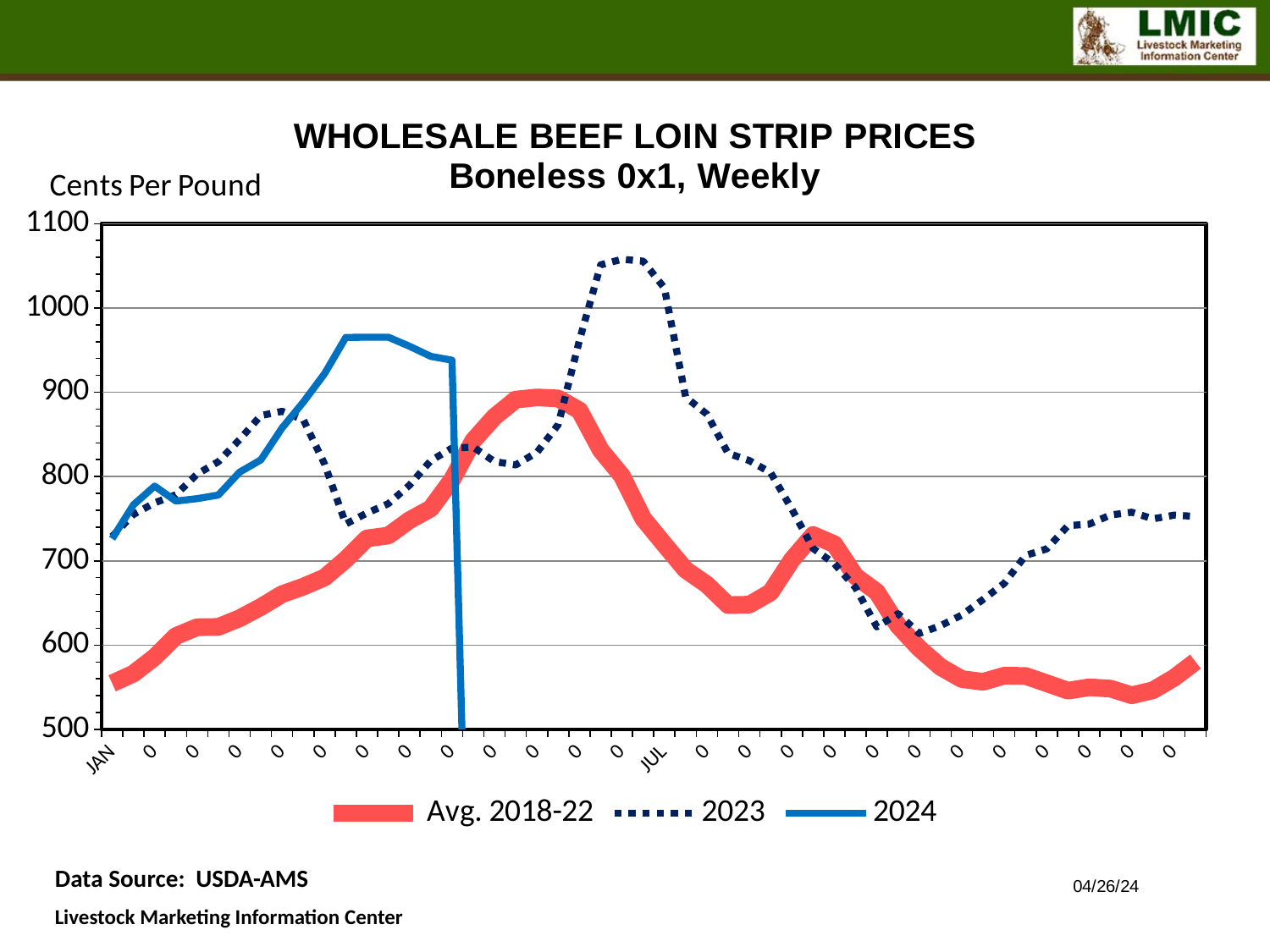
What kind of chart is shown on the slide? line chart Which series reaches the highest value on the chart? 2023 How many series does the legend list? 3 Is the 2023 value at JAN greater or less than 700? greater Is the peak value of the 2023 series greater or less than 1000? greater What unit is shown on the vertical axis label? Cents Per Pound Is the highest value of the 2024 series greater or less than 900? greater Does the Avg. 2018-22 series rise or fall from JAN to its peak around mid-year? rise What is the title of the chart? WHOLESALE BEEF LOIN STRIP PRICES Boneless 0x1, Weekly At JAN, which is higher: the 2023 series or the Avg. 2018-22 series? 2023